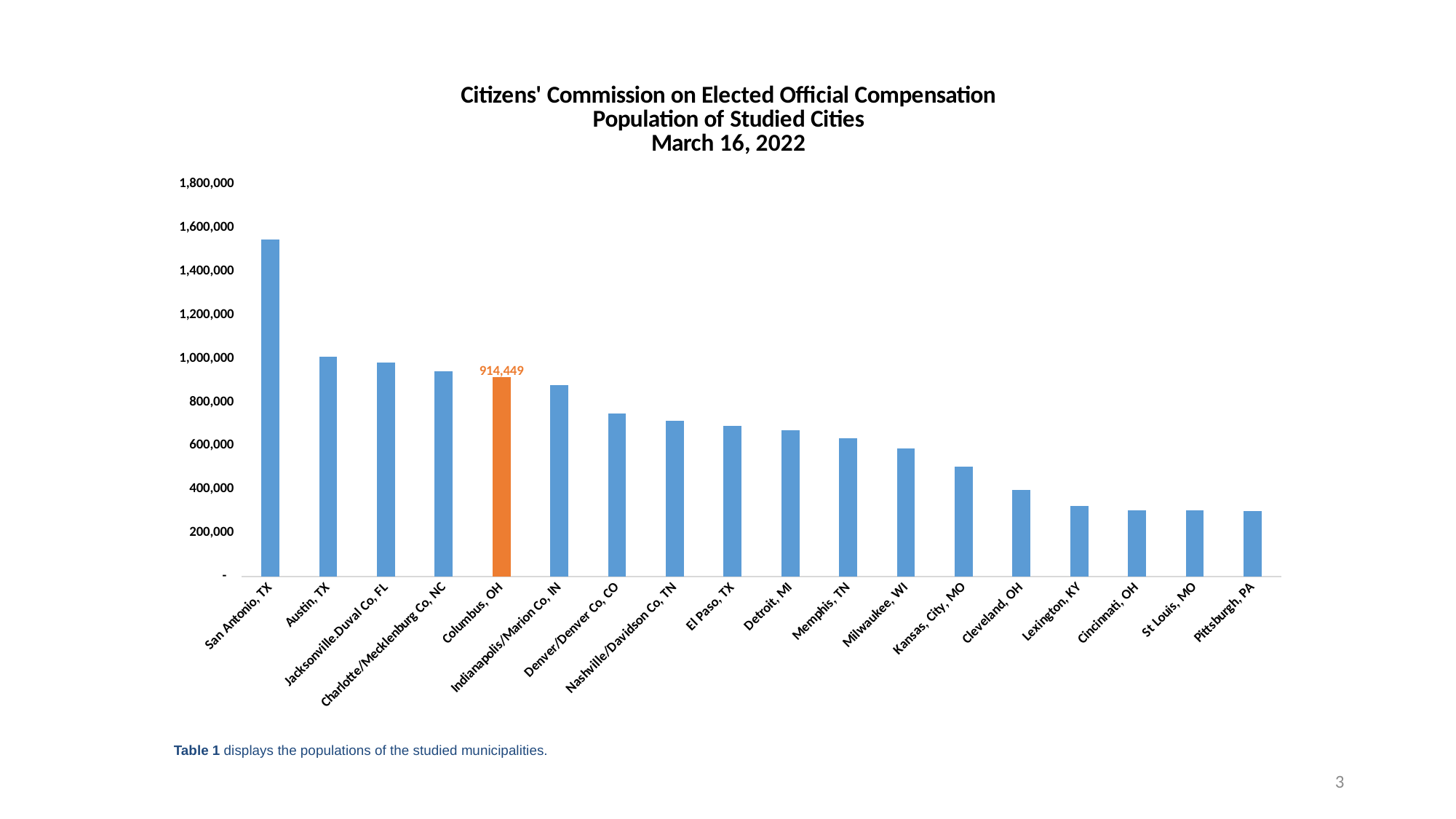
Is the value for Kansas City, MO greater or less than 400,000? greater What is the population shown for Columbus, OH? 914,449 Which city's bar is highlighted in orange? Columbus, OH Is the value for Denver/Denver Co, CO greater or less than 800,000? less Is the value for Lexington, KY greater or less than 400,000? less Which city has the highest population in the chart? San Antonio, TX How many cities are shown in the chart? 18 What kind of chart is shown on the slide? Bar chart Which has a larger population, San Antonio, TX or Austin, TX? San Antonio, TX Do the bar values rise or fall from left to right across the chart? Fall Which has a larger population, Kansas City, MO or Cleveland, OH? Kansas City, MO